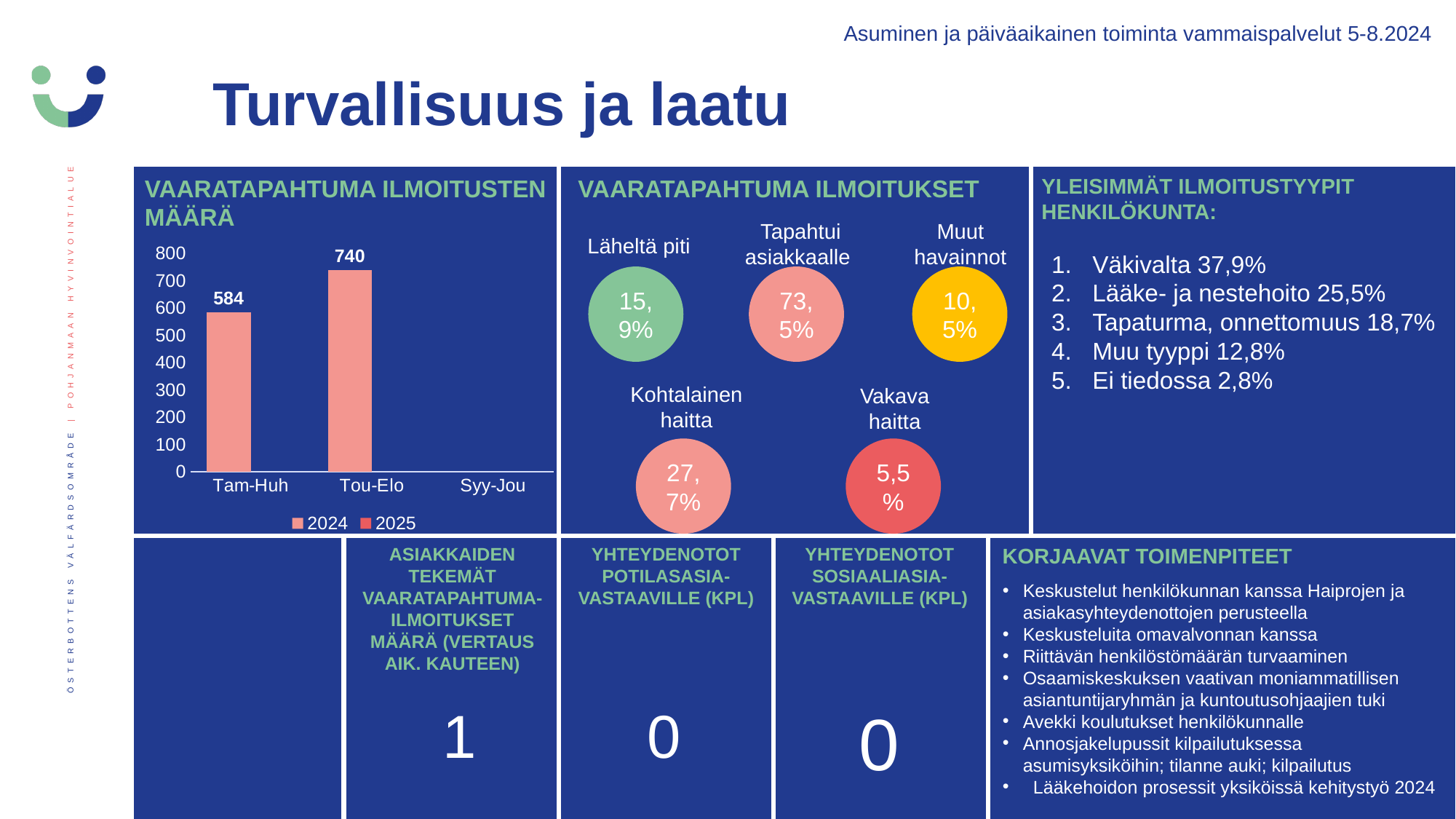
In the chart titled "VAARATAPAHTUMA ILMOITUSTEN MÄÄRÄ", what are the two entries in the legend? 2024 and 2025 In the chart titled "VAARATAPAHTUMA ILMOITUSTEN MÄÄRÄ", what is the value for Tou-Elo? 740 In the chart titled "VAARATAPAHTUMA ILMOITUSTEN MÄÄRÄ", is the value for Tou-Elo greater or less than 800? less What kind of chart is the one titled "VAARATAPAHTUMA ILMOITUSTEN MÄÄRÄ"? bar chart In the chart titled "VAARATAPAHTUMA ILMOITUSTEN MÄÄRÄ", which is larger, the value for Tam-Huh or the value for Tou-Elo? Tou-Elo In the chart titled "VAARATAPAHTUMA ILMOITUSTEN MÄÄRÄ", which of the two plotted bars is the lower one? Tam-Huh In the chart titled "VAARATAPAHTUMA ILMOITUSTEN MÄÄRÄ", is the value for Tam-Huh greater or less than 500? greater In the chart titled "VAARATAPAHTUMA ILMOITUSTEN MÄÄRÄ", how many categories are shown on the x axis? 3 In the chart titled "VAARATAPAHTUMA ILMOITUSTEN MÄÄRÄ", how many series does the legend list? 2 In the chart titled "VAARATAPAHTUMA ILMOITUSTEN MÄÄRÄ", what is the value for Tam-Huh? 584 In the chart titled "VAARATAPAHTUMA ILMOITUSTEN MÄÄRÄ", what is the difference between the values for Tou-Elo and Tam-Huh? 156 In the chart titled "VAARATAPAHTUMA ILMOITUSTEN MÄÄRÄ", which category has the highest bar? Tou-Elo